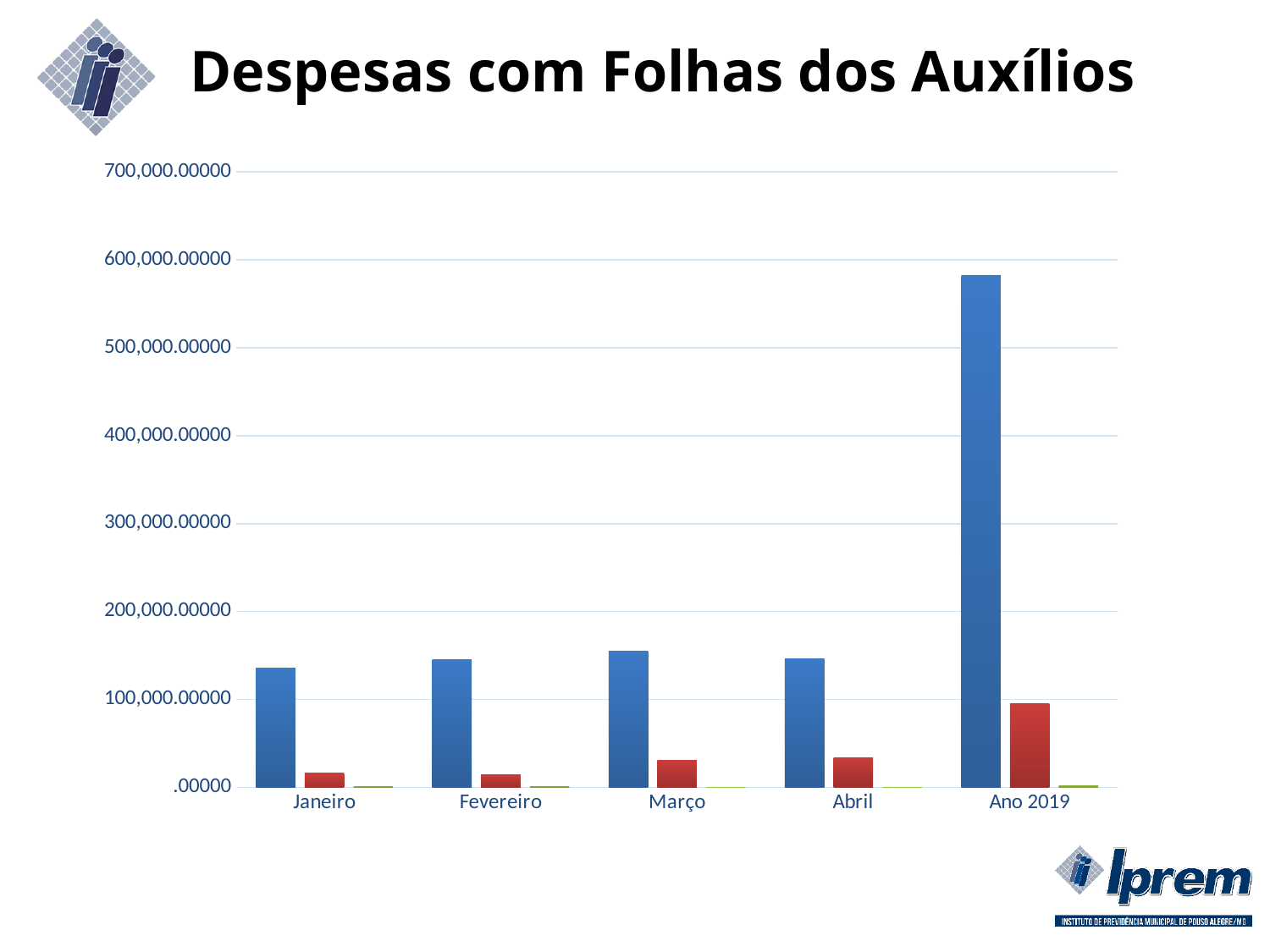
Which is larger, the red bar for Ano 2019 or the red bar for Abril? Ano 2019 Among the months Janeiro, Fevereiro, Março and Abril, which has the shortest blue bar? Janeiro Is the blue bar for Janeiro greater or less than 100,000.00000? greater What is the title of the chart? Despesas com Folhas dos Auxílios Which category has the tallest blue bar? Ano 2019 Is the blue bar for Março greater or less than 200,000.00000? less How many categories are shown on the x axis of the chart? 5 Is the blue bar for Ano 2019 greater or less than 500,000.00000? greater Which is larger, the blue bar for Março or the blue bar for Janeiro? Março What kind of chart is shown on the slide? bar chart